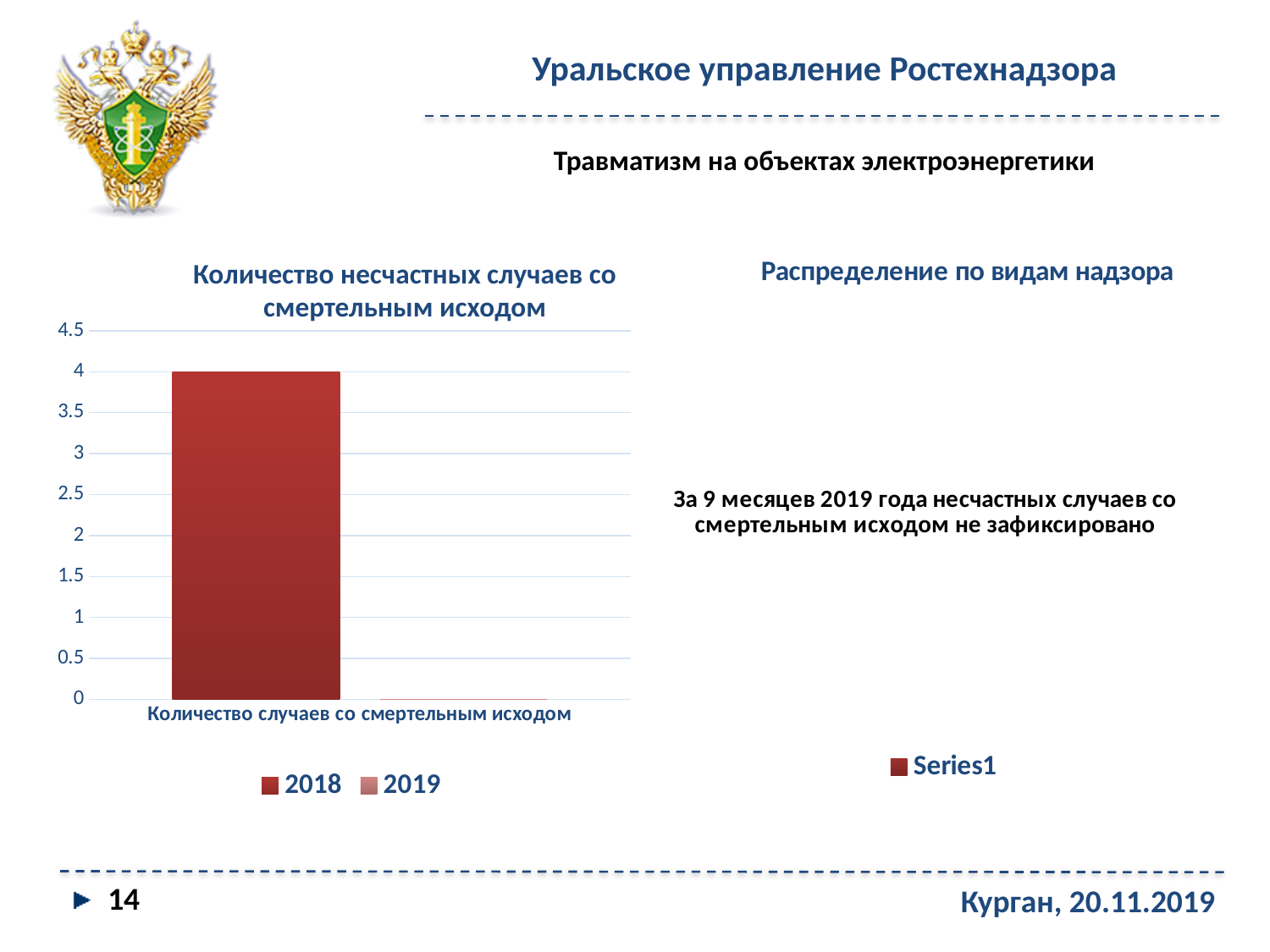
In the chart 'Количество несчастных случаев со смертельным исходом', which series has the higher value, 2018 or 2019? 2018 In the chart 'Количество несчастных случаев со смертельным исходом', what is the difference between the 2018 and 2019 values? 4 What is the title of the chart on the right side of the slide? Распределение по видам надзора What is the category label on the x axis of the chart 'Количество несчастных случаев со смертельным исходом'? Количество случаев со смертельным исходом In the chart 'Количество несчастных случаев со смертельным исходом', is the value for 2018 greater or less than 3? greater In the chart 'Количество несчастных случаев со смертельным исходом', what is the value for 2018? 4 What kind of chart is 'Количество несчастных случаев со смертельным исходом'? bar chart In the chart 'Количество несчастных случаев со смертельным исходом', which series has the lowest value? 2019 In the chart 'Количество несчастных случаев со смертельным исходом', what is the value for 2019? 0 What is the maximum value shown on the y axis of the chart 'Количество несчастных случаев со смертельным исходом'? 4.5 How many series does the legend of the chart 'Количество несчастных случаев со смертельным исходом' list? 2